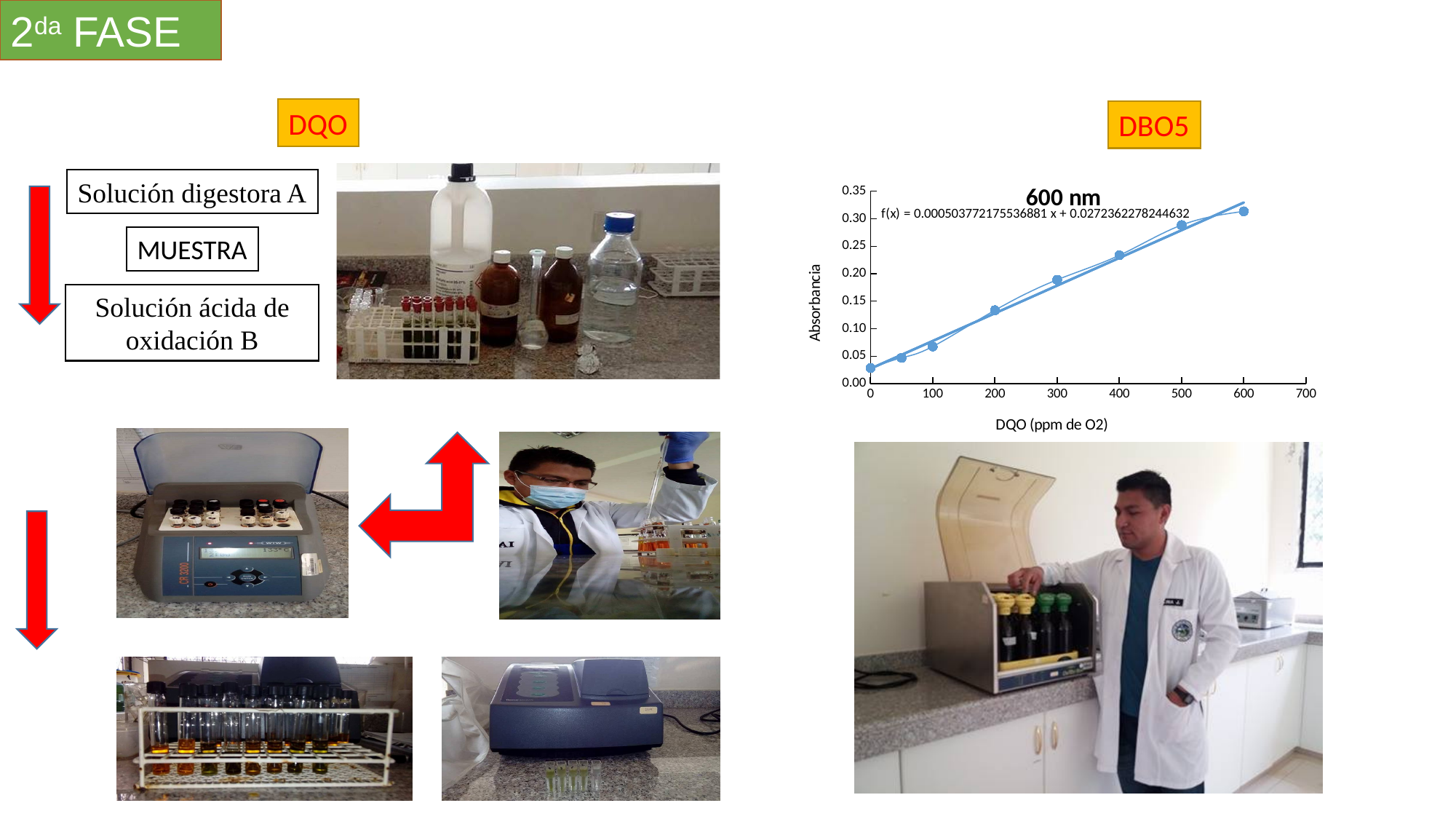
How many data points are plotted in the chart? 8 What kind of chart is shown under the DBO5 heading? Scatter chart with a trend line At which DQO value is the absorbance lowest? 0 Is the absorbance at DQO 400 greater or less than 0.20? greater At which DQO value is the absorbance highest? 600 Is the absorbance at DQO 300 greater or less than 0.15? greater Does absorbance rise or fall as DQO increases along the x axis? Rises Which has the higher absorbance, DQO 200 or DQO 400? DQO 400 Is the absorbance at DQO 500 greater or less than 0.25? greater What is the label of the x axis of the chart? DQO (ppm de O2) What is the title of the chart? 600 nm